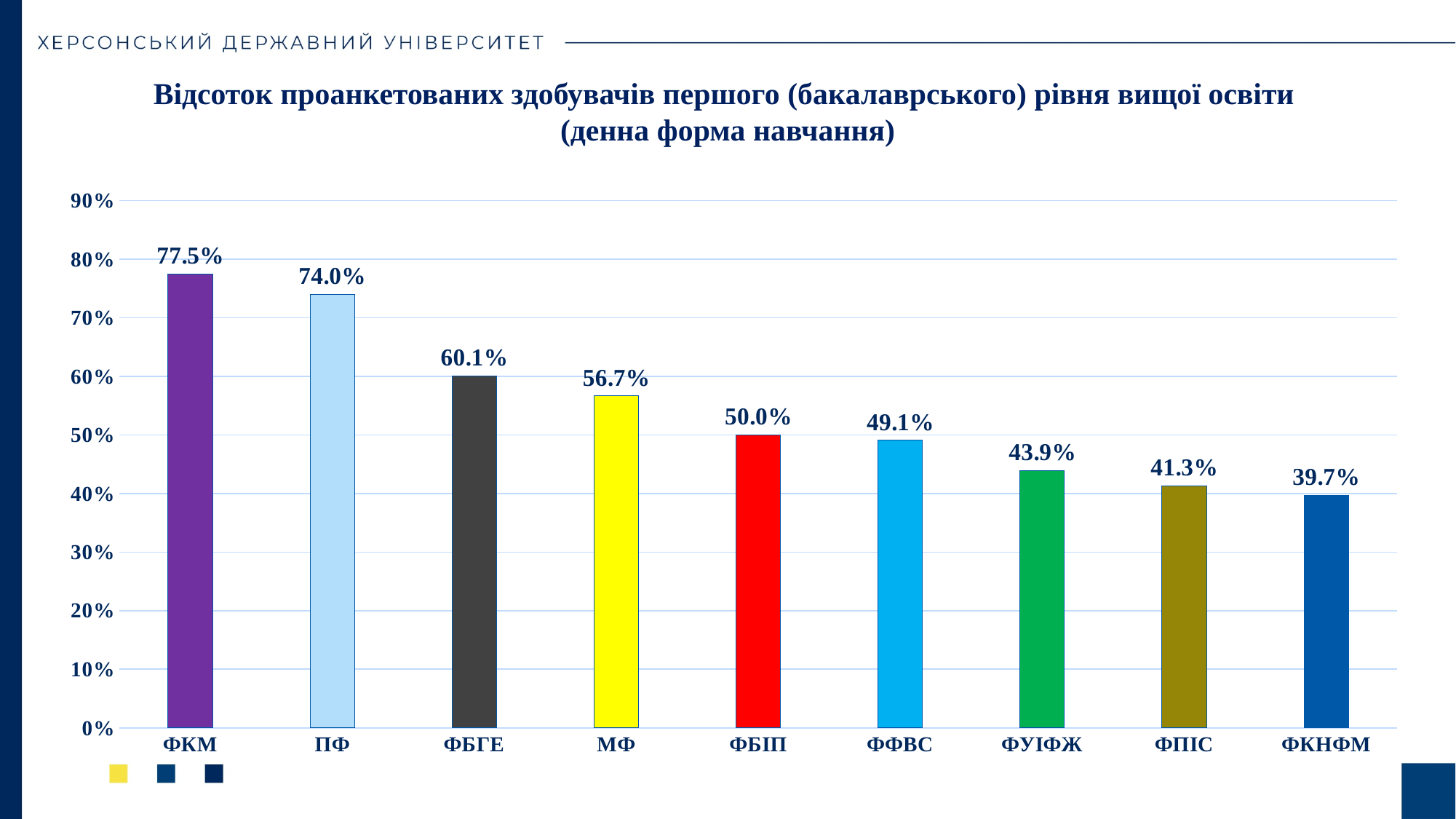
What is the difference between the values for ФКМ and ФКНФМ? 37.8% What kind of chart is shown on the slide? bar chart Which category has the lowest value? ФКНФМ What is the value for ФПІС? 41.3% What is the value for ФБІП? 50.0% Do the values rise or fall from left to right along the x axis? fall Is the value for ФУІФЖ greater or less than 50%? less What is the value for ФКМ? 77.5% Which category has the highest value? ФКМ How many categories are shown on the x axis? 9 Which is larger, the value for МФ or the value for ФФВС? МФ What is the difference between the values for ПФ and ФБГЕ? 13.9%